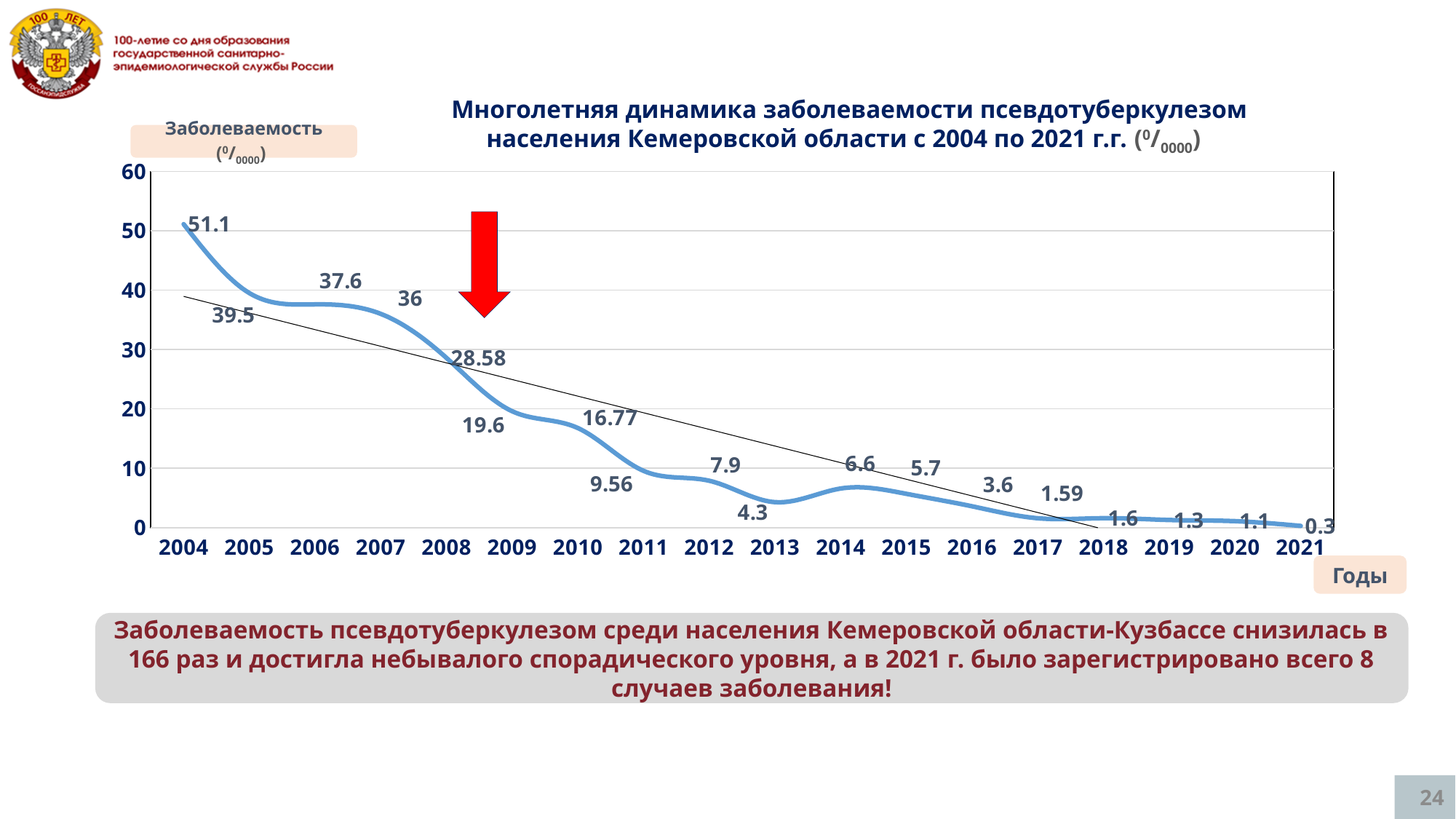
What is the label shown on the x axis of the chart? Годы Which year has the lowest incidence value? 2021 What is the incidence value for 2004? 51.1 What is the incidence value for 2021? 0.3 Which year has the larger incidence value, 2013 or 2014? 2014 What is the incidence value for 2014? 6.6 How many years are plotted on the x axis? 18 What is the incidence value for 2008? 28.58 Which year has the highest incidence value? 2004 Do the incidence values generally rise or fall from 2004 to 2021? fall What kind of chart is shown on the slide? line chart What is the difference between the incidence values for 2004 and 2021? 50.8